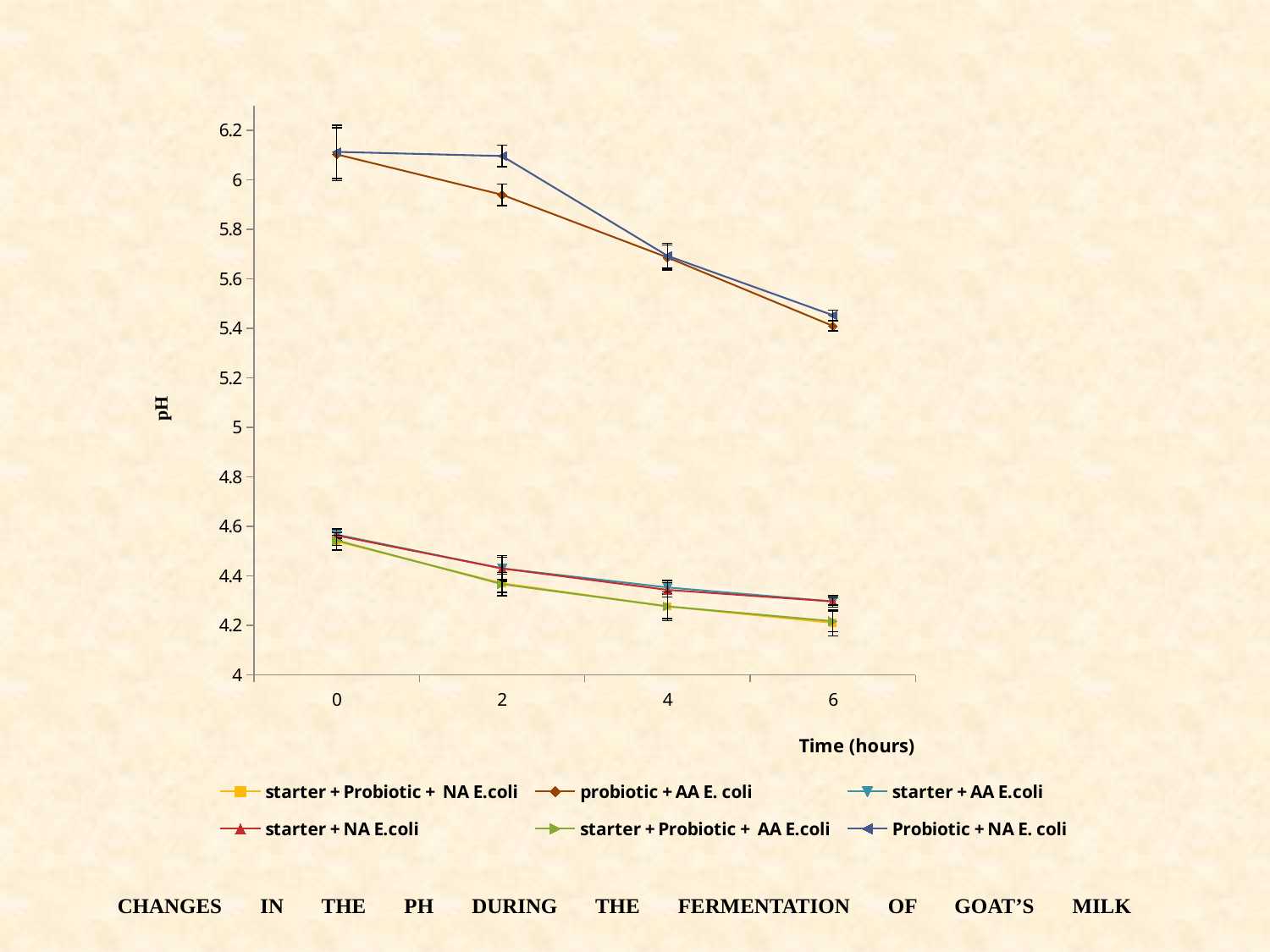
Is the pH for Probiotic + NA E. coli at 6 hours greater or less than 5.6? less What is the label of the y axis? pH Which series has the highest pH at 2 hours? Probiotic + NA E. coli Is the pH for probiotic + AA E. coli at 0 hours greater or less than 6? greater What kind of chart is shown on the slide? line chart Is the pH for starter + NA E.coli at 0 hours greater or less than 4.8? less How many series does the legend list? 6 At 2 hours, which has the higher pH: Probiotic + NA E. coli or probiotic + AA E. coli? Probiotic + NA E. coli What is the label of the x axis? Time (hours) How many time points are plotted along the x axis? 4 Do the pH values rise or fall as time increases from 0 to 6 hours? fall